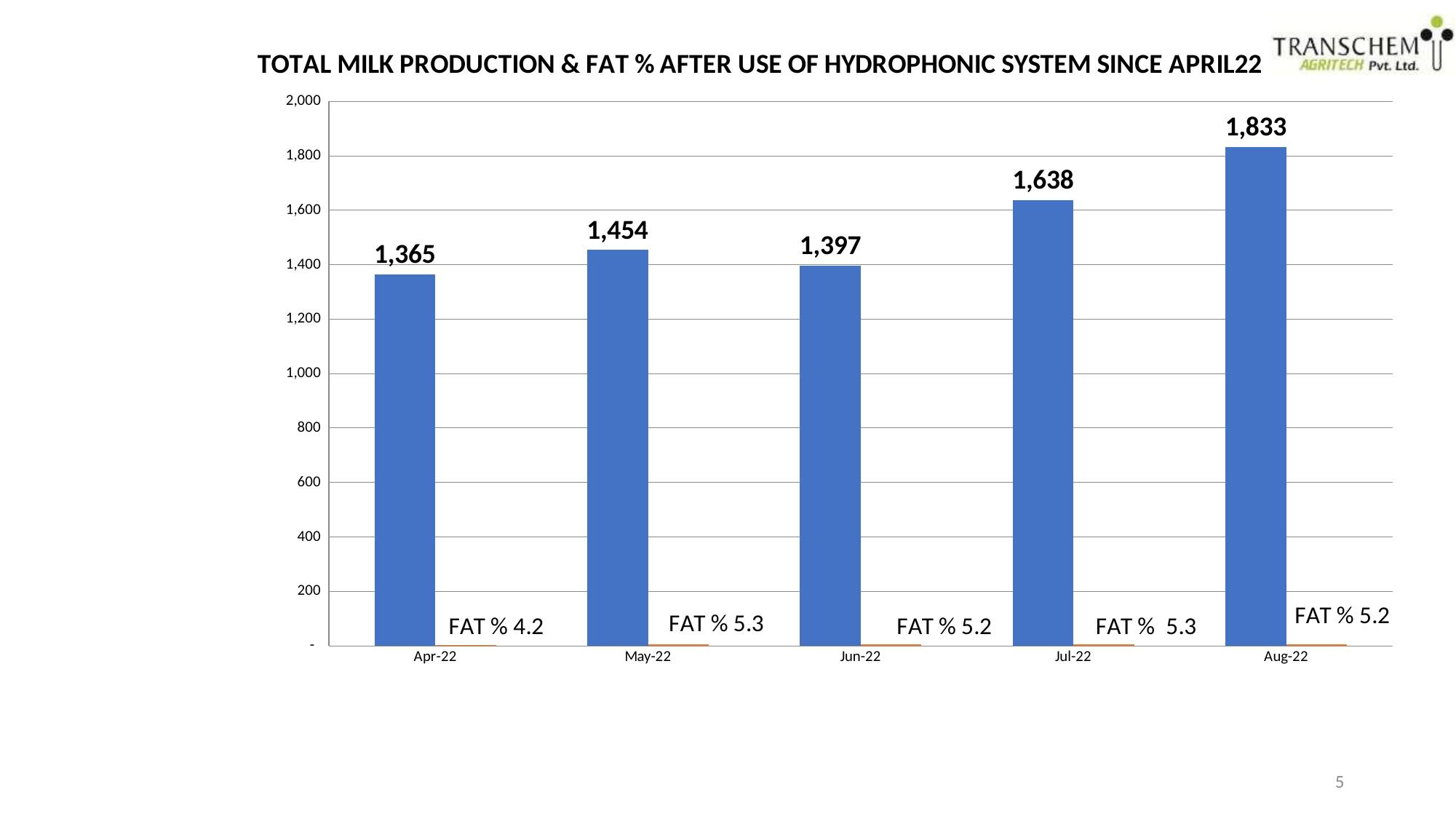
How many months are shown on the x axis? 5 Which month has the highest total milk production? Aug-22 What is the difference in milk production between May-22 and Apr-22? 89 What is the total milk production for Apr-22? 1,365 What FAT % is shown for Apr-22? 4.2 What is the difference in milk production between Aug-22 and Jul-22? 195 What is the total milk production for Jun-22? 1,397 Which month has the lowest total milk production? Apr-22 Is the milk production for Jul-22 greater or less than 1,600? greater What kind of chart is shown on the slide? Bar chart Which month has higher milk production, May-22 or Jun-22? May-22 What is the total milk production for Aug-22? 1,833